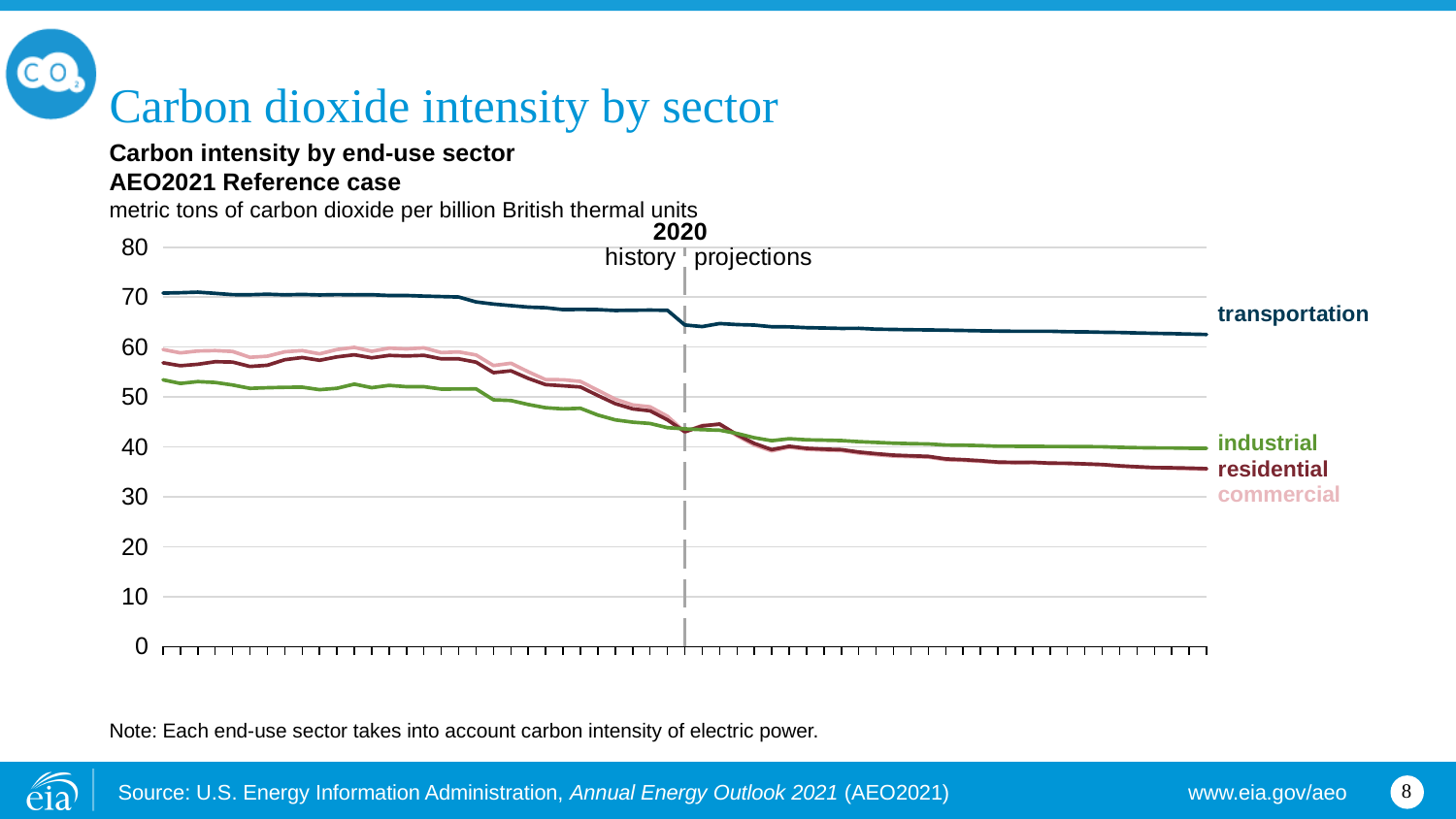
Is the value for transportation at the end of the projection period greater or less than 60? greater How many sectors (series) are plotted on the chart? 4 Is the value for residential at the end of the projection period greater or less than 40? less What year does the dashed vertical line separating history from projections mark? 2020 Does the transportation line rise or fall from left to right? fall Which sector has the highest carbon intensity across the whole chart? transportation What kind of chart is shown on the slide? line chart What unit is the chart measured in? metric tons of carbon dioxide per billion British thermal units Is the value for industrial at the start of the history period greater or less than 50? greater At the 2020 dividing line, which is larger: transportation or industrial? transportation Which sector has the lowest carbon intensity at the start of the history period? industrial